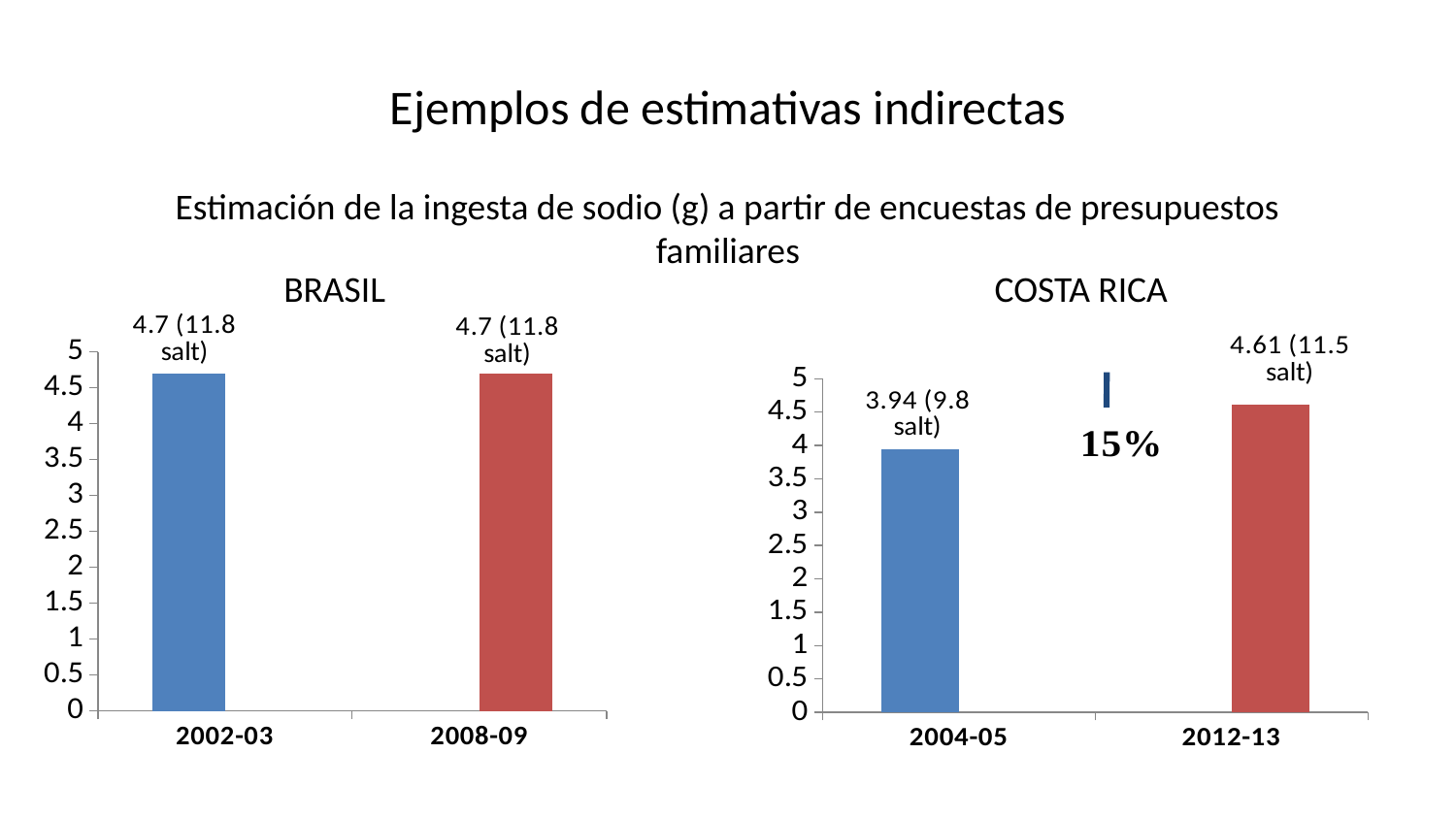
In the BRASIL chart, what is the data label for 2008-09? 4.7 (11.8 salt) In the COSTA RICA chart, is the value for 2004-05 greater or less than 4? less In the COSTA RICA chart, what is the difference in sodium (g) between 2012-13 and 2004-05? 0.67 In the BRASIL chart, how many periods are plotted? 2 What percentage change is annotated between the two bars in the COSTA RICA chart? 15% In the COSTA RICA chart, do the values rise or fall from 2004-05 to 2012-13? rise In the COSTA RICA chart, which period has the higher value? 2012-13 In the BRASIL chart, what is the data label for 2002-03? 4.7 (11.8 salt) In the COSTA RICA chart, what is the data label for 2004-05? 3.94 (9.8 salt) What type of chart is the COSTA RICA chart? bar chart In the COSTA RICA chart, what is the data label for 2012-13? 4.61 (11.5 salt) In the COSTA RICA chart, which period has the lower value? 2004-05